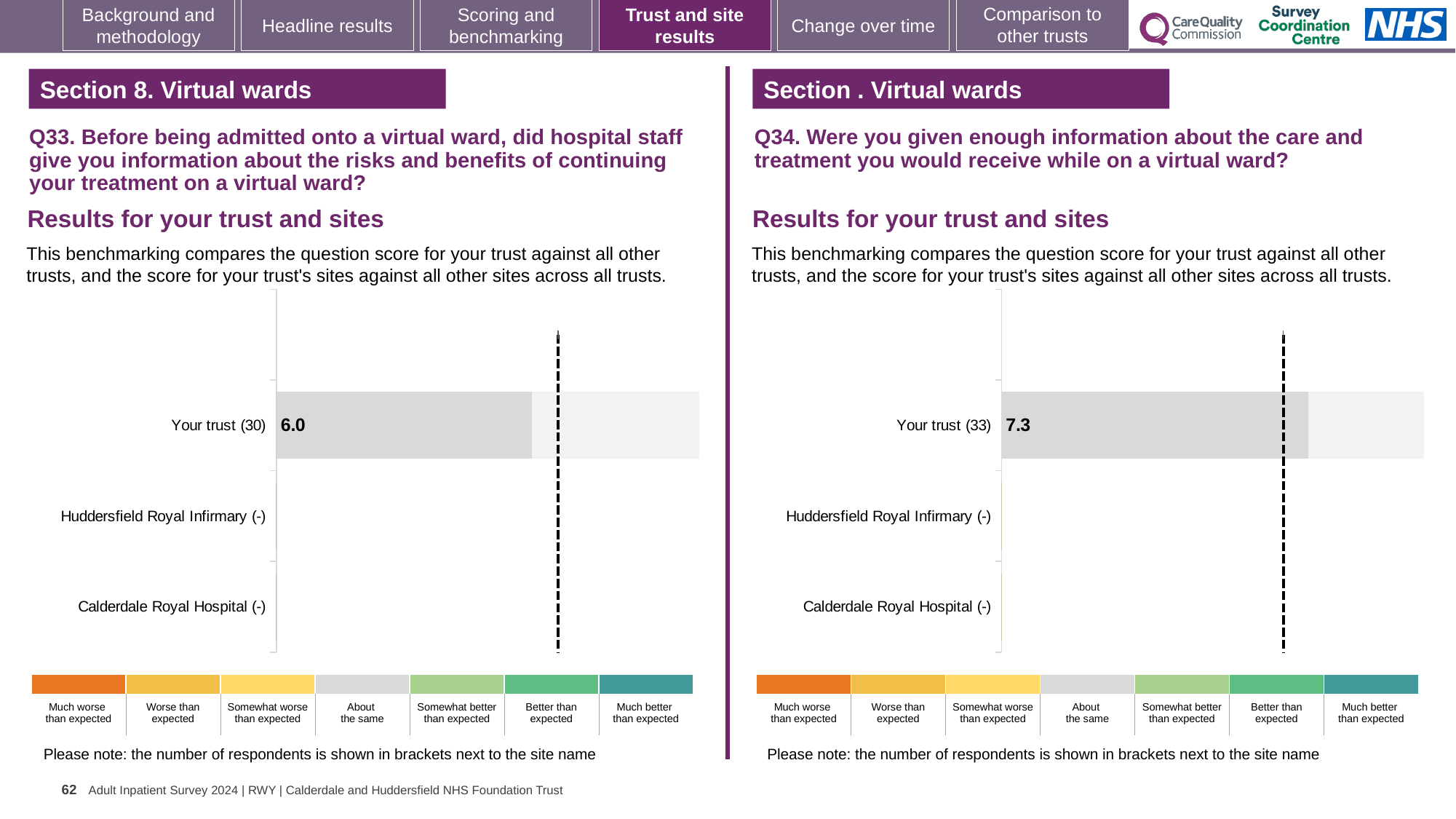
In the Q33 chart on the left, how many respondents are shown in brackets next to Your trust? 30 In the Q33 chart on the left, what is the score for Your trust? 6.0 How many categories (rows) are listed on the y axis of the Q33 chart on the left? 3 In the Q33 chart on the left, which category has the highest score? Your trust (30) In the Q34 chart on the right, which category has the highest score? Your trust (33) How many benchmark bands are shown in the colour key below each chart? 7 What kind of chart is the Q33 chart on the left? Bar chart How many categories (rows) are listed on the y axis of the Q34 chart on the right? 3 What is the difference between the Your trust score in the Q34 chart on the right and the Your trust score in the Q33 chart on the left? 1.3 In the Q34 chart on the right, how many respondents are shown in brackets next to Your trust? 33 In the Q34 chart on the right, what is the score for Your trust? 7.3 Which chart shows the higher score for Your trust, the Q33 chart on the left or the Q34 chart on the right? The Q34 chart on the right